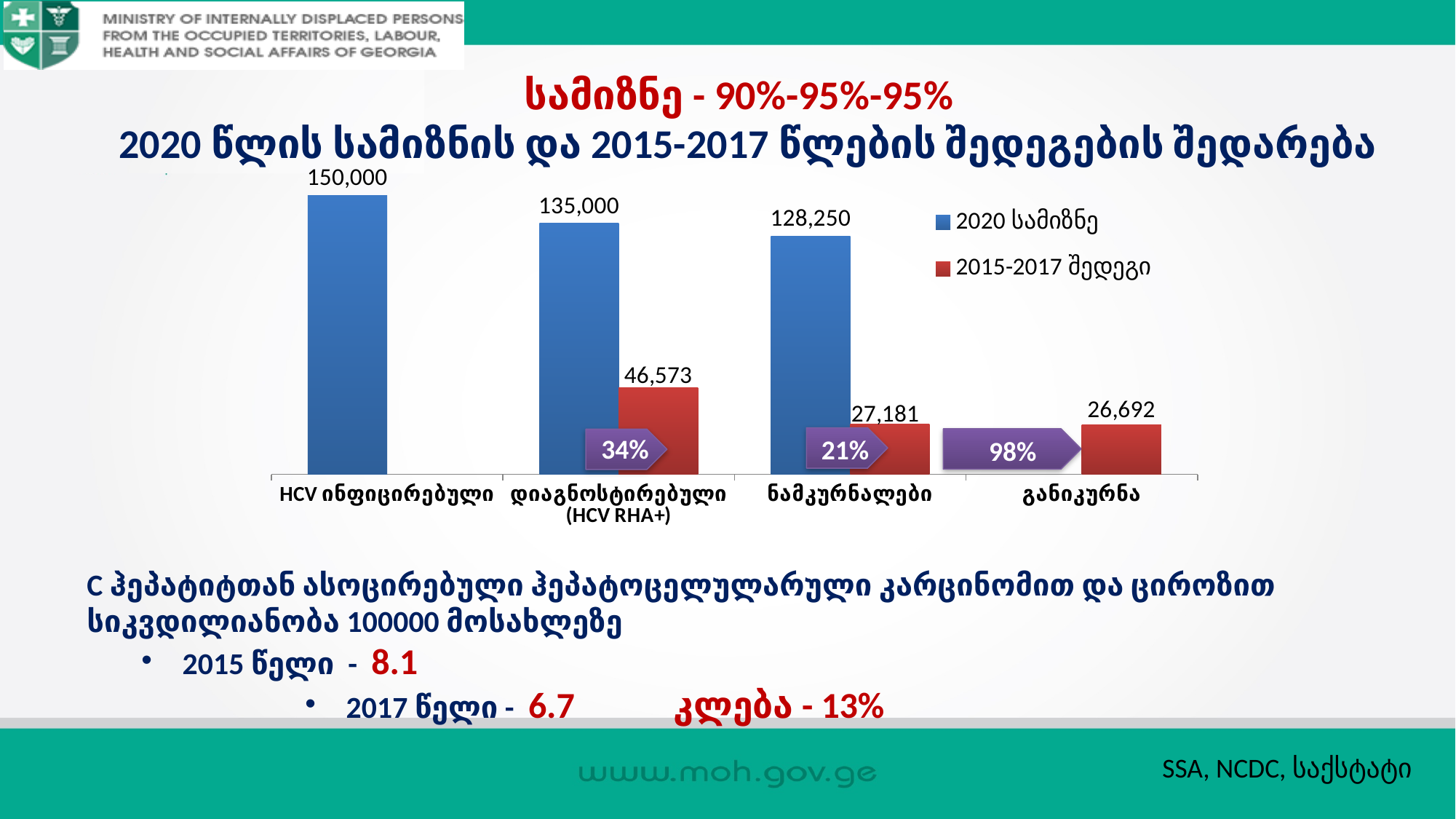
How many categories are shown on the x axis of the chart? 4 What kind of chart is shown on the slide? Bar chart How many series does the chart legend list? 2 What is the 2015-2017 შედეგი value for განიკურნა? 26,692 Which colour represents the 2015-2017 შედეგი series in the chart? Red Which category has the highest 2020 სამიზნე value? HCV ინფიცირებული What is the 2015-2017 შედეგი value for დიაგნოსტირებული (HCV RHA+)? 46,573 What is the difference between the 2020 სამიზნე and the 2015-2017 შედეგი for ნამკურნალები? 101,069 What is the 2020 სამიზნე value for ნამკურნალები? 128,250 Which category has the lowest 2015-2017 შედეგი value? განიკურნა Which is larger for დიაგნოსტირებული (HCV RHA+): the 2020 სამიზნე or the 2015-2017 შედეგი? 2020 სამიზნე What is the 2020 სამიზნე value for HCV ინფიცირებული? 150,000